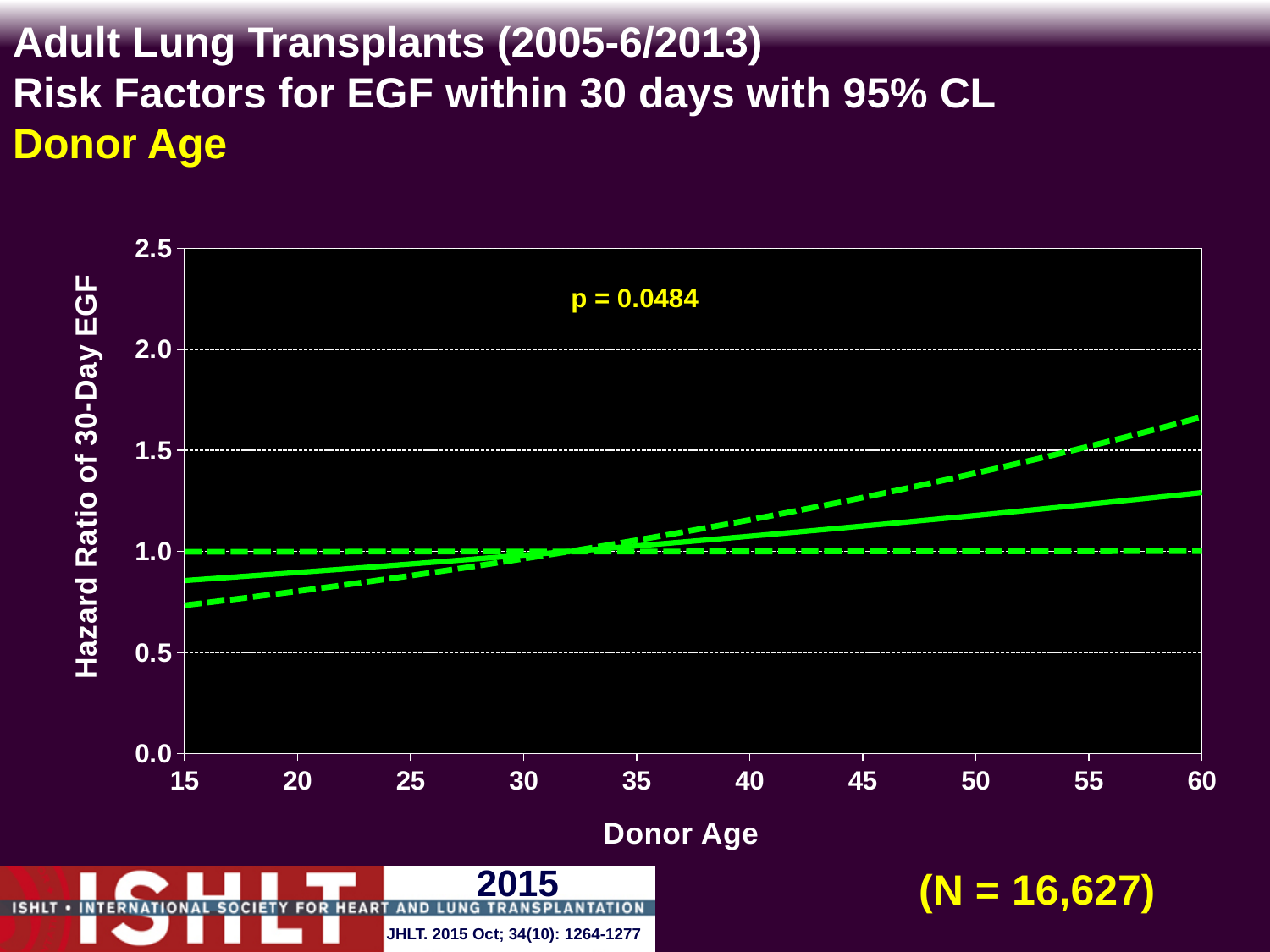
What is the label of the x axis? Donor Age Is the hazard ratio (solid line) at donor age 60 greater or less than 1.0? greater What is the highest value shown on the y axis? 2.5 Is the hazard ratio (solid line) at donor age 60 greater or less than 1.5? less What is the label of the y axis? Hazard Ratio of 30-Day EGF Is the hazard ratio (solid line) at donor age 15 greater or less than 1.0? less Does the solid hazard ratio line rise or fall as donor age increases along the x axis? rise What sample size (N) is printed on the slide? N = 16,627 What kind of chart is shown on the slide? line chart What is the p-value printed on the chart? p = 0.0484